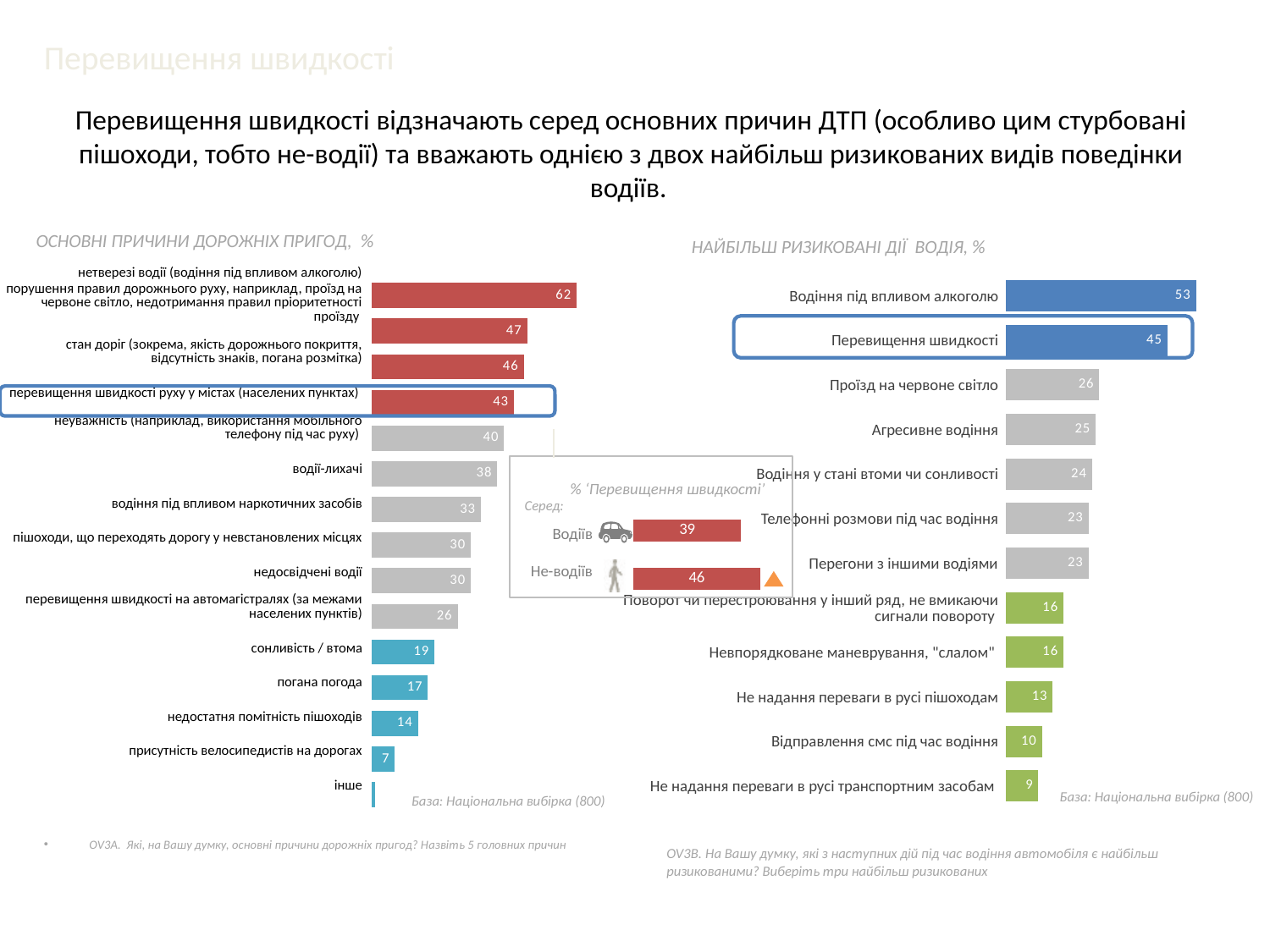
In the chart 'ОСНОВНІ ПРИЧИНИ ДОРОЖНІХ ПРИГОД, %', what is the value for 'перевищення швидкості руху у містах (населених пунктах)'? 43 What type of chart is 'ОСНОВНІ ПРИЧИНИ ДОРОЖНІХ ПРИГОД, %'? Bar chart In the chart 'ОСНОВНІ ПРИЧИНИ ДОРОЖНІХ ПРИГОД, %', what is the value for 'нетверезі водії'? 62 In the chart 'НАЙБІЛЬШ РИЗИКОВАНІ ДІЇ ВОДІЯ, %', what is the value for 'Перевищення швидкості'? 45 In the chart 'НАЙБІЛЬШ РИЗИКОВАНІ ДІЇ ВОДІЯ, %', how many categories are shown? 12 In the chart 'ОСНОВНІ ПРИЧИНИ ДОРОЖНІХ ПРИГОД, %', what is the difference between 'перевищення швидкості руху у містах' and 'перевищення швидкості на автомагістралях'? 17 In the inset chart '% Перевищення швидкості', what is the value for 'Не-водіїв'? 46 In the chart 'ОСНОВНІ ПРИЧИНИ ДОРОЖНІХ ПРИГОД, %', which category has the lowest labelled value? присутність велосипедистів на дорогах In the chart 'НАЙБІЛЬШ РИЗИКОВАНІ ДІЇ ВОДІЯ, %', which category has the highest value? Водіння під впливом алкоголю In the chart 'НАЙБІЛЬШ РИЗИКОВАНІ ДІЇ ВОДІЯ, %', which is larger: 'Проїзд на червоне світло' or 'Відправлення смс під час водіння'? Проїзд на червоне світло In the chart 'НАЙБІЛЬШ РИЗИКОВАНІ ДІЇ ВОДІЯ, %', what is the difference between 'Водіння під впливом алкоголю' and 'Перевищення швидкості'? 8 In the chart 'НАЙБІЛЬШ РИЗИКОВАНІ ДІЇ ВОДІЯ, %', which category has the lowest value? Не надання переваги в русі транспортним засобам